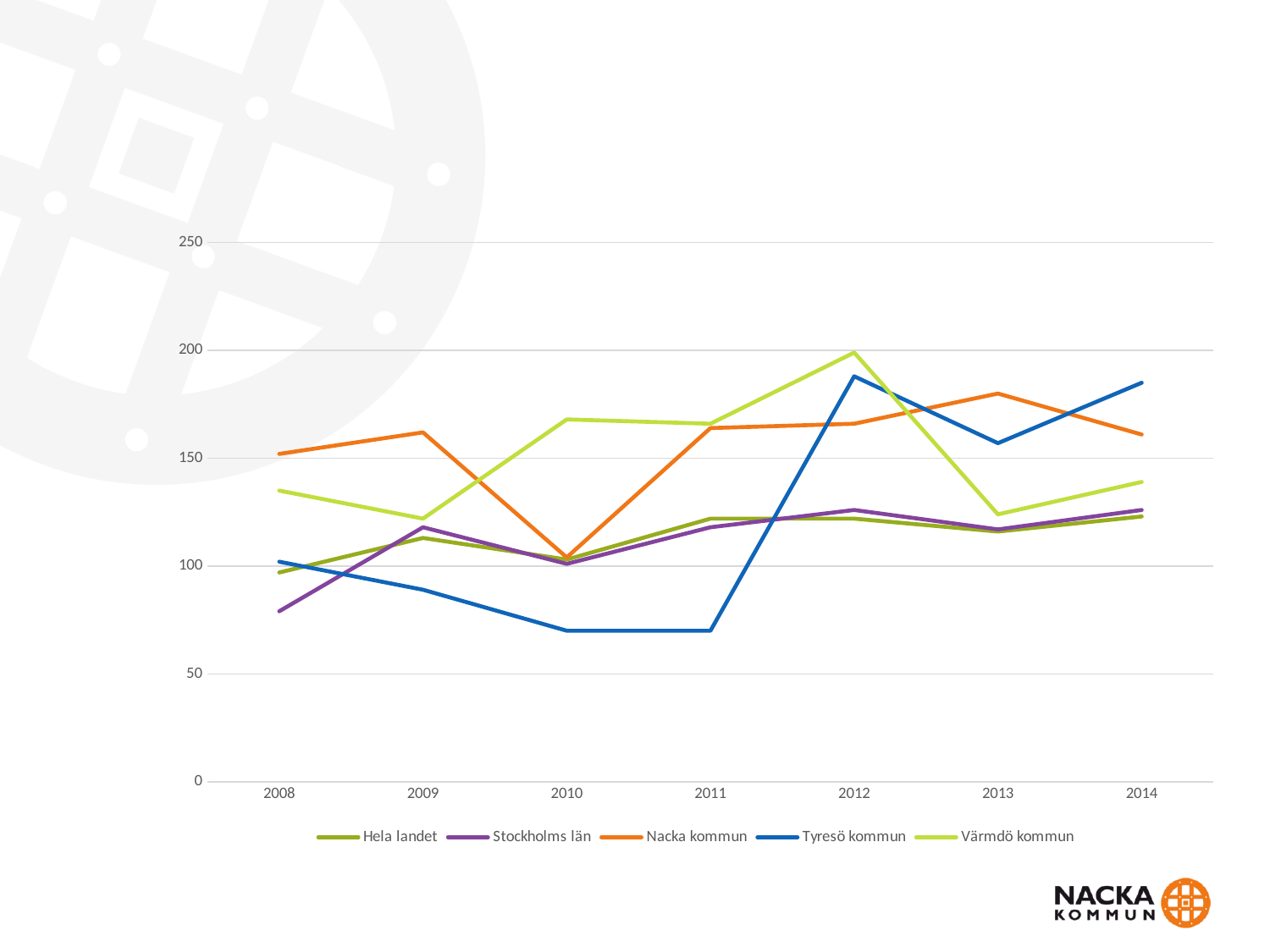
Is the value for Värmdö kommun in 2012 greater or less than 150? greater What colour is the line for Nacka kommun? orange How many series does the legend list? 5 Does the value for Tyresö kommun rise or fall from 2008 to 2010? fall What kind of chart is shown on the slide? line chart Which series has the lowest value in 2008? Stockholms län Which series has the highest value in 2012? Värmdö kommun In 2011, which is larger: the value for Nacka kommun or the value for Tyresö kommun? Nacka kommun Which series has the lowest value in 2011? Tyresö kommun Is the value for Nacka kommun in 2013 greater or less than 150? greater How many years are shown on the x axis? 7 Is the value for Tyresö kommun in 2010 greater or less than 100? less